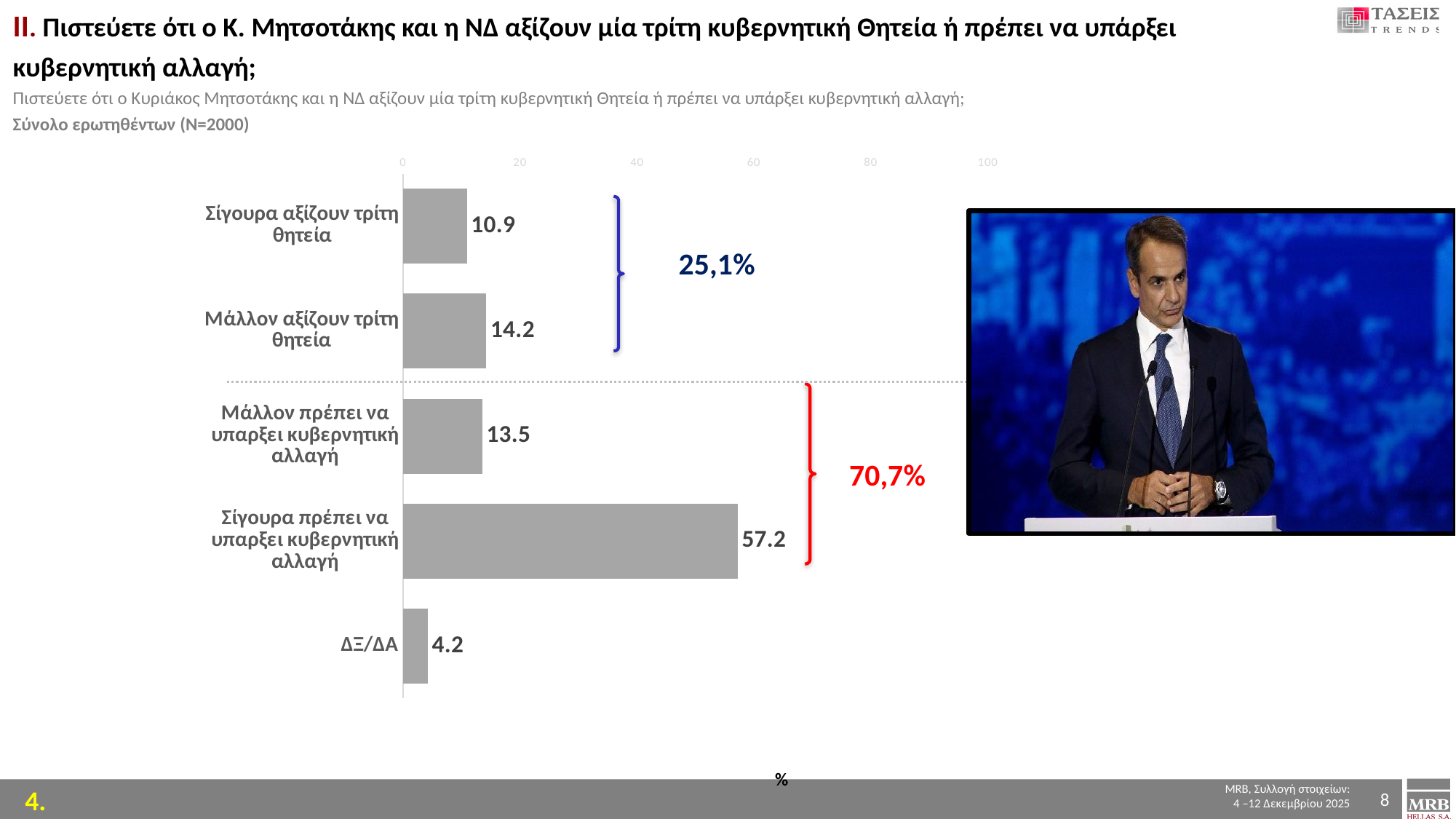
Which is larger: 'Μάλλον αξίζουν τρίτη θητεία' or 'Σίγουρα αξίζουν τρίτη θητεία'? Μάλλον αξίζουν τρίτη θητεία Which category has the lowest value? ΔΞ/ΔΑ What is the value for 'Μάλλον αξίζουν τρίτη θητεία'? 14.2 What is the value for 'Σίγουρα πρέπει να υπαρξει κυβερνητική αλλαγή'? 57.2 What kind of chart is shown on the slide? bar chart Is the value for 'Σίγουρα πρέπει να υπαρξει κυβερνητική αλλαγή' greater or less than 40? greater What is the difference between 'Σίγουρα πρέπει να υπαρξει κυβερνητική αλλαγή' and 'Μάλλον πρέπει να υπαρξει κυβερνητική αλλαγή'? 43.7 What is the value for 'Σίγουρα αξίζουν τρίτη θητεία'? 10.9 What is the value for 'ΔΞ/ΔΑ'? 4.2 How many categories are shown in the chart? 5 Which category has the highest value? Σίγουρα πρέπει να υπαρξει κυβερνητική αλλαγή What combined percentage is shown by the red bracket for the two 'κυβερνητική αλλαγή' categories? 70,7%